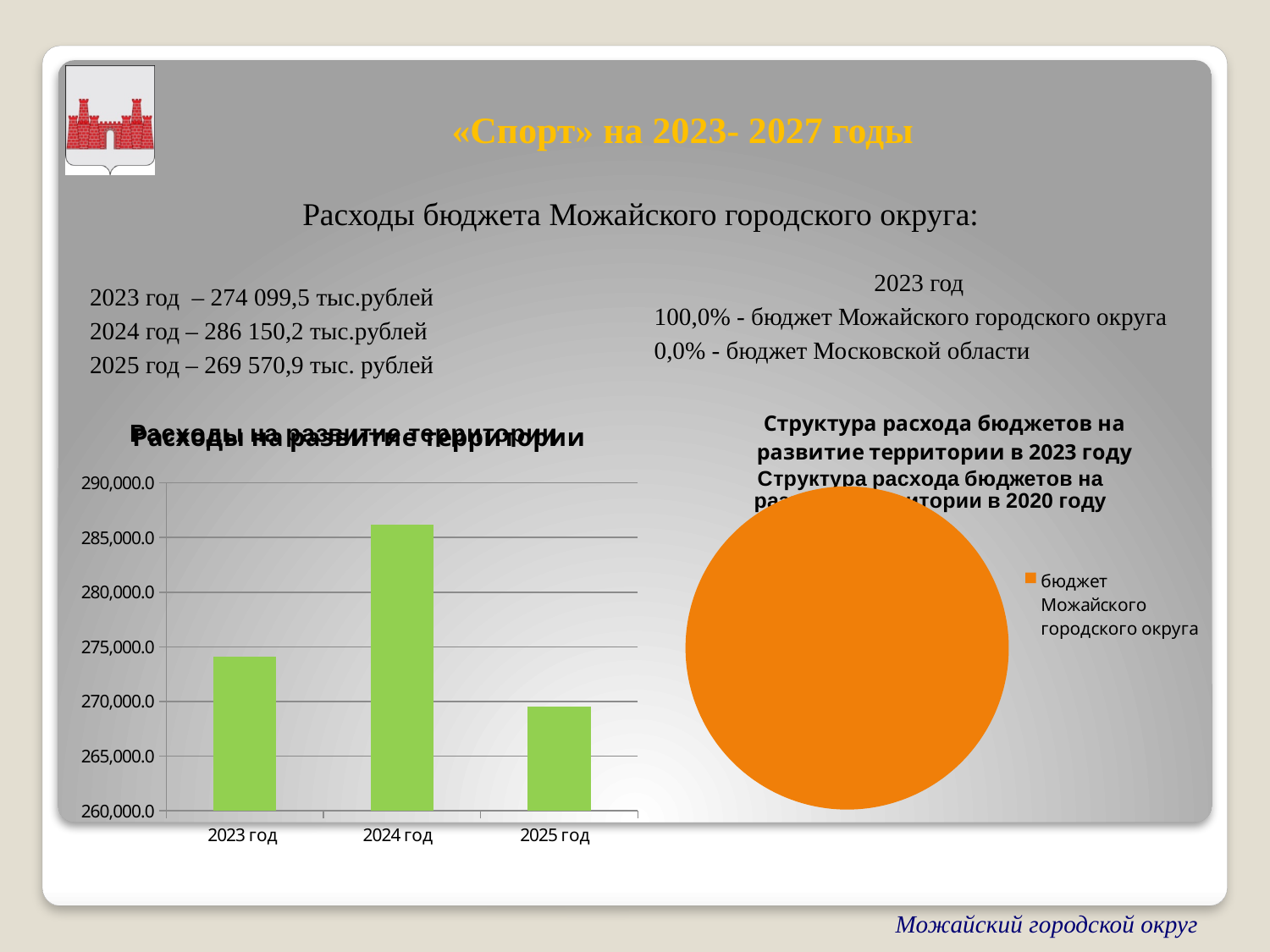
In the bar chart "Расходы на развитие территории", which year has the highest value? 2024 год In the bar chart "Расходы на развитие территории", is the value for 2023 год greater or less than 270,000.0? greater In the bar chart "Расходы на развитие территории", is the value for 2025 год greater or less than 265,000.0? greater In the pie chart on the right, what share does "бюджет Можайского городского округа" have? 100,0% What kind of chart is the chart titled "Структура расхода бюджетов на развитие территории в 2023 году"? pie chart In the bar chart "Расходы на развитие территории", which year has the lowest value? 2025 год In the bar chart "Расходы на развитие территории", does the value rise or fall from 2024 год to 2025 год? fall In the bar chart "Расходы на развитие территории", is the value for 2024 год greater or less than 290,000.0? less What kind of chart is the chart titled "Расходы на развитие территории"? bar chart In the bar chart "Расходы на развитие территории", which is larger: the value for 2023 год or the value for 2025 год? 2023 год In the pie chart on the right, how many entries does the legend list? 1 In the bar chart "Расходы на развитие территории", how many bars are plotted? 3